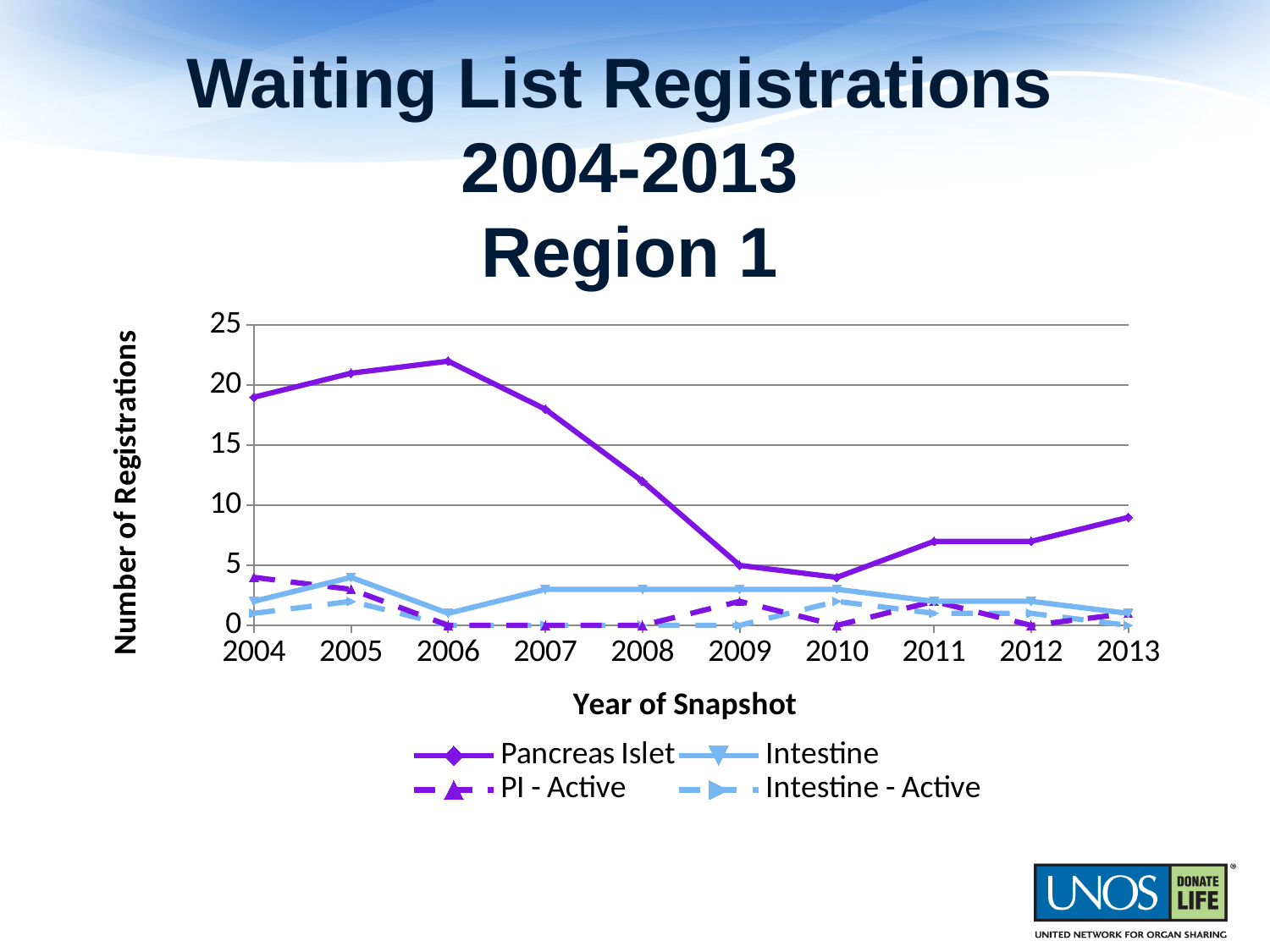
Is the Pancreas Islet value for 2006 greater or less than 20? greater How many years are plotted along the x axis? 10 Is the Pancreas Islet value for 2011 greater or less than 5? greater Does the Pancreas Islet series rise or fall between 2006 and 2010? fall In which year does the Pancreas Islet series reach its highest value? 2006 What kind of chart is shown on the slide? line chart Is the Pancreas Islet value for 2008 greater or less than 10? greater In 2004, which is larger: the Pancreas Islet value or the Intestine value? Pancreas Islet How many series does the legend list? 4 What is the PI - Active value for 2007? 0 What is the label of the y axis? Number of Registrations